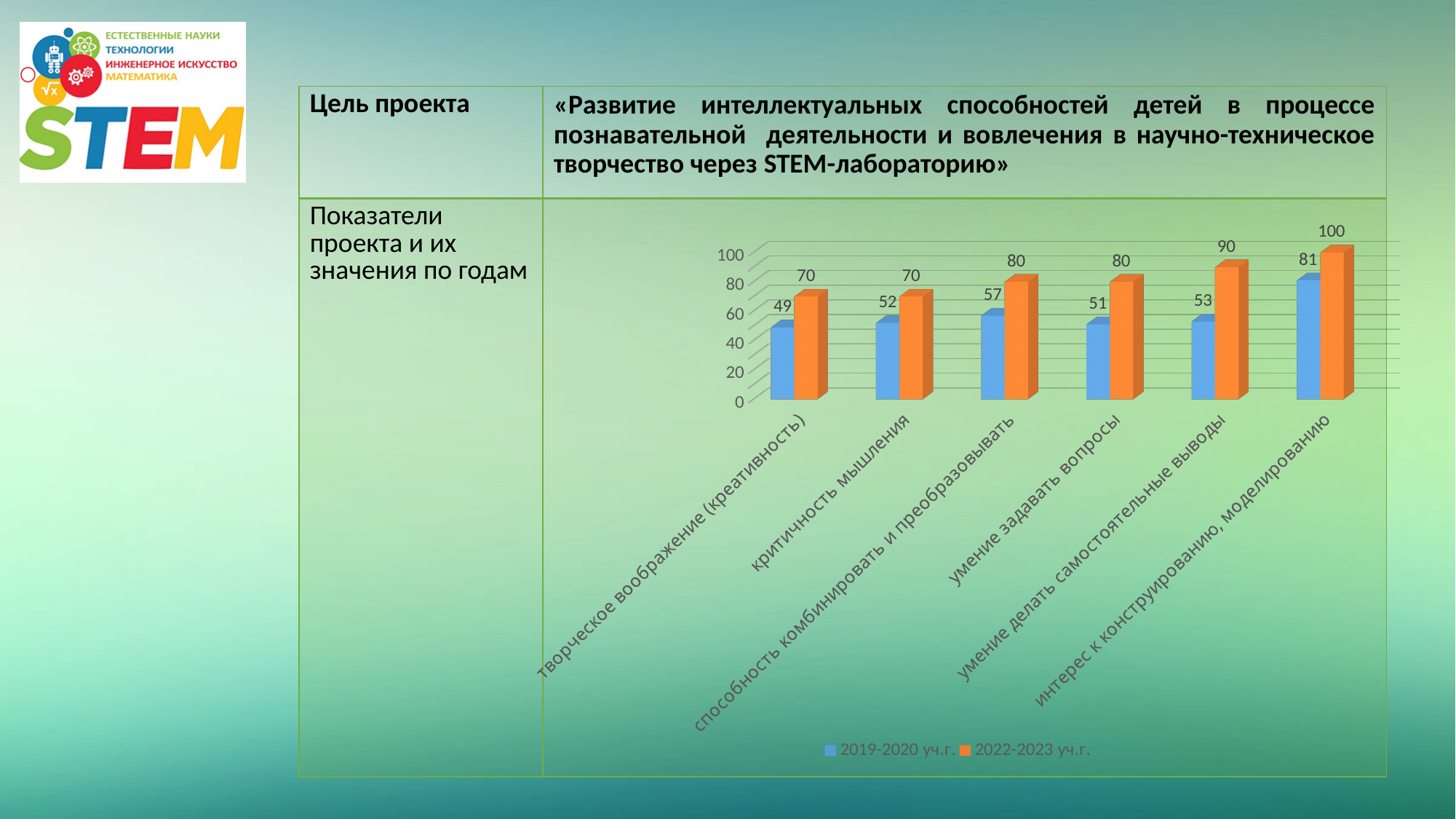
Which category has the lowest value in the 2019-2020 уч.г. series? творческое воображение (креативность) What is the difference between the 2022-2023 уч.г. and 2019-2020 уч.г. values for 'умение задавать вопросы'? 29 Which is larger: the 2019-2020 уч.г. value for 'критичность мышления' or the 2019-2020 уч.г. value for 'способность комбинировать и преобразовывать'? способность комбинировать и преобразовывать What is the value for 'интерес к конструированию, моделированию' in the 2019-2020 уч.г. series? 81 What are the two series names listed in the chart legend? 2019-2020 уч.г. and 2022-2023 уч.г. What is the value for 'творческое воображение (креативность)' in the 2019-2020 уч.г. series? 49 How many categories are shown on the x axis of the chart? 6 What is the value for 'умение делать самостоятельные выводы' in the 2022-2023 уч.г. series? 90 Do the 2022-2023 уч.г. values generally rise or fall from left to right along the x axis? Rise Which category has the highest value in the 2022-2023 уч.г. series? интерес к конструированию, моделированию How many series does the chart legend list? 2 What type of chart is shown on the slide? Bar chart